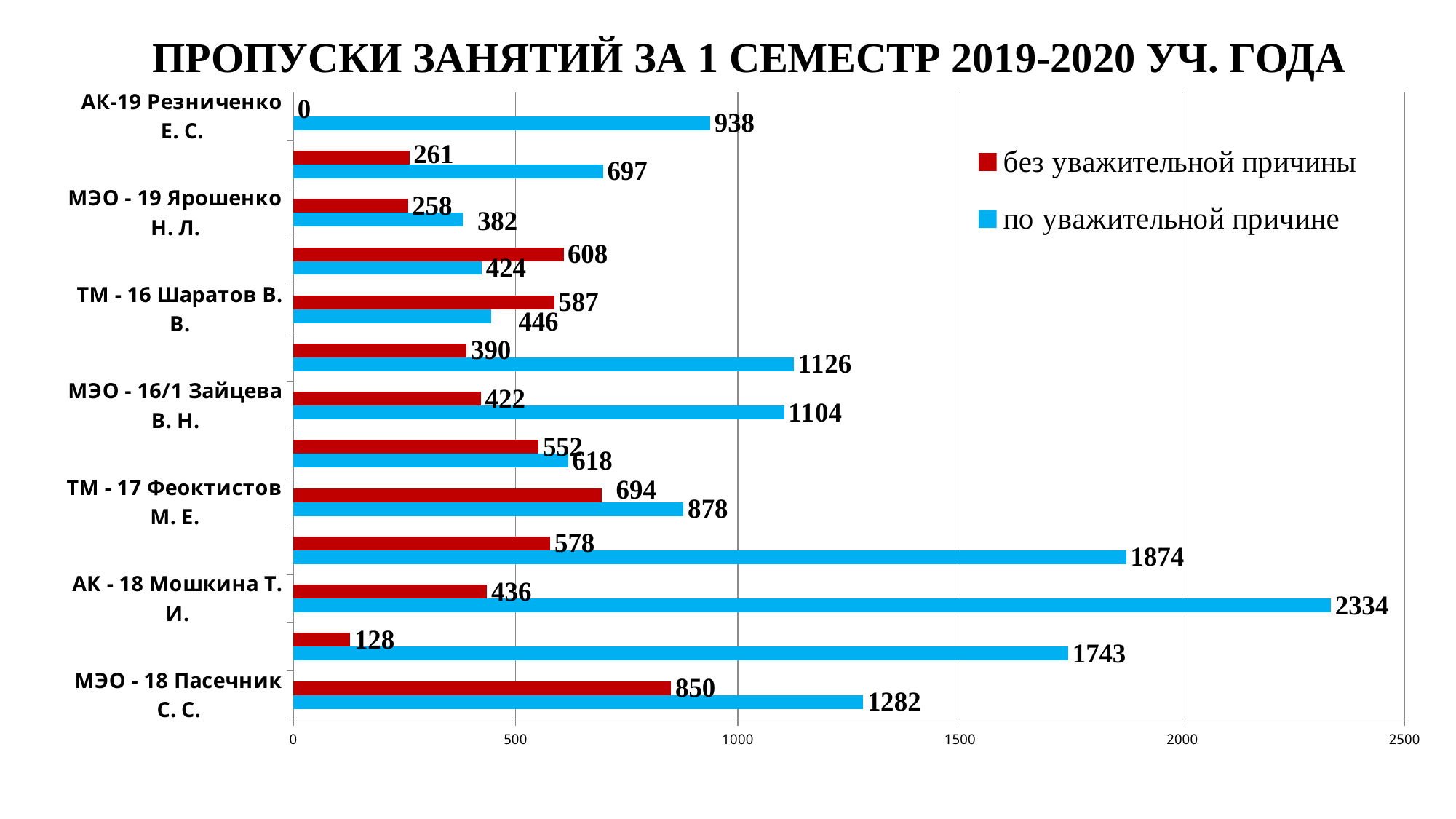
What is the value of 'по уважительной причине' for АК - 18 Мошкина Т. И.? 2334 Which labeled category has the lowest value for 'без уважительной причины'? АК-19 Резниченко Е. С. How many series does the legend list? 2 Which labeled category has the highest value for 'по уважительной причине'? АК - 18 Мошкина Т. И. Is the value of 'по уважительной причине' for МЭО - 18 Пасечник С. С. greater or less than 1000? greater What is the value of 'без уважительной причины' for МЭО - 18 Пасечник С. С.? 850 What is the title of the chart? ПРОПУСКИ ЗАНЯТИЙ ЗА 1 СЕМЕСТР 2019-2020 УЧ. ГОДА What is the value of 'по уважительной причине' for АК-19 Резниченко Е. С.? 938 What kind of chart is shown on the slide? bar chart What is the value of 'без уважительной причины' for ТМ - 16 Шаратов В. В.? 587 For ТМ - 17 Феоктистов М. Е., which is larger: 'без уважительной причины' or 'по уважительной причине'? по уважительной причине What is the difference between 'по уважительной причине' and 'без уважительной причины' for МЭО - 16/1 Зайцева В. Н.? 682